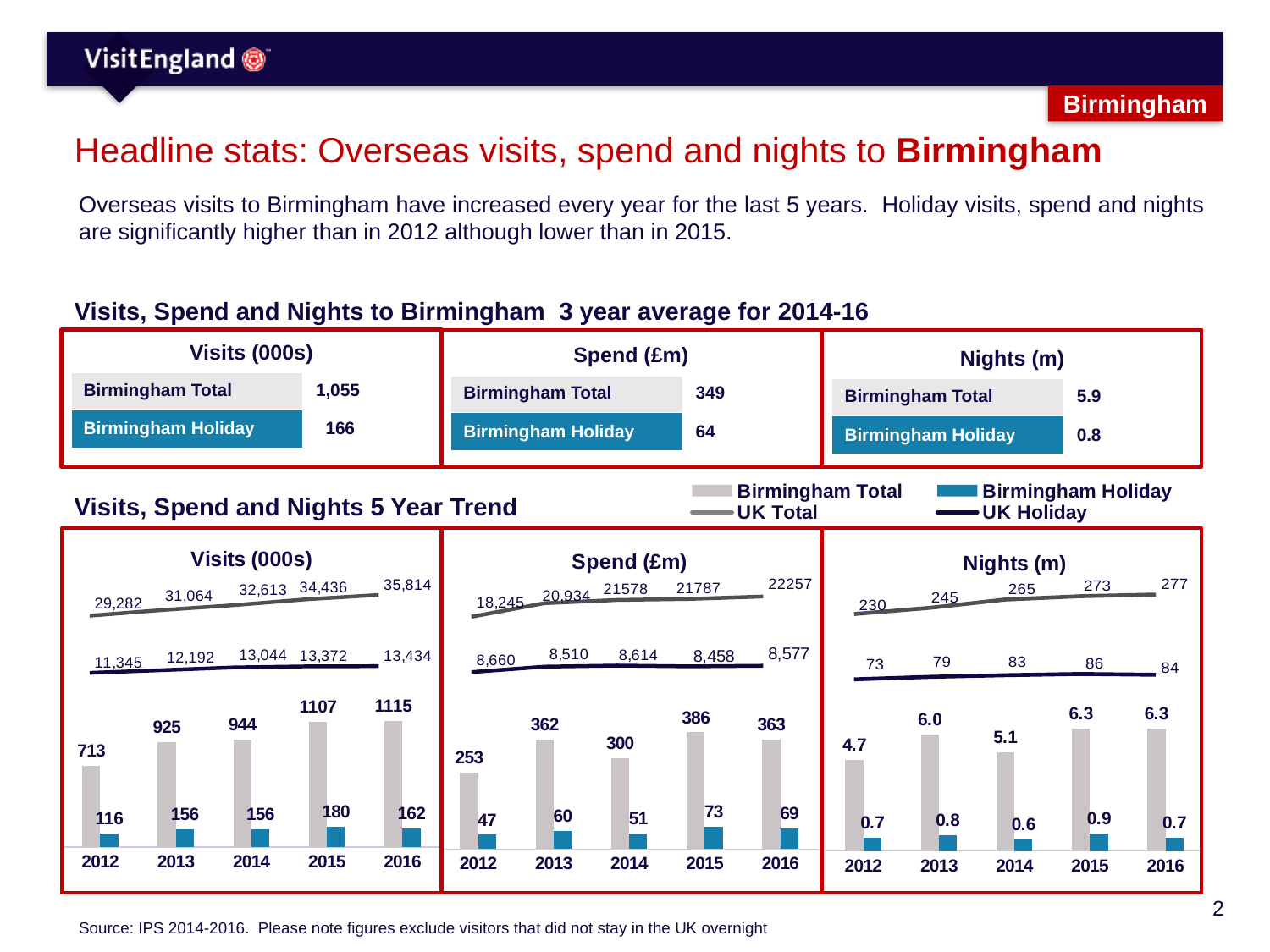
In the Spend (£m) 5 year trend chart, what is the Birmingham Holiday value for 2013? 60 How many years are shown on the x axis of the Nights (m) 5 year trend chart? 5 In the Nights (m) 5 year trend chart, what is the UK Total value for 2014? 265 In the Spend (£m) 5 year trend chart, which is larger: the Birmingham Total value for 2013 or for 2014? 2013 In the 5 Year Trend legend, which series is shown in dark blue bars? Birmingham Holiday What kind of chart is used for the Birmingham Total and Birmingham Holiday series in the Visits (000s) 5 year trend chart? bar chart In the Visits (000s) 5 year trend chart, what is the Birmingham Total value for 2015? 1107 In the Spend (£m) 5 year trend chart, which year has the highest Birmingham Total value? 2015 In the Nights (m) 5 year trend chart, which year has the lowest Birmingham Holiday value? 2014 How many series does the legend for the 5 Year Trend charts list? 4 In the Visits (000s) 5 year trend chart, what is the difference between the Birmingham Total values for 2016 and 2012? 402 In the Visits (000s) 5 year trend chart, does the UK Total line rise or fall from 2012 to 2016? rise